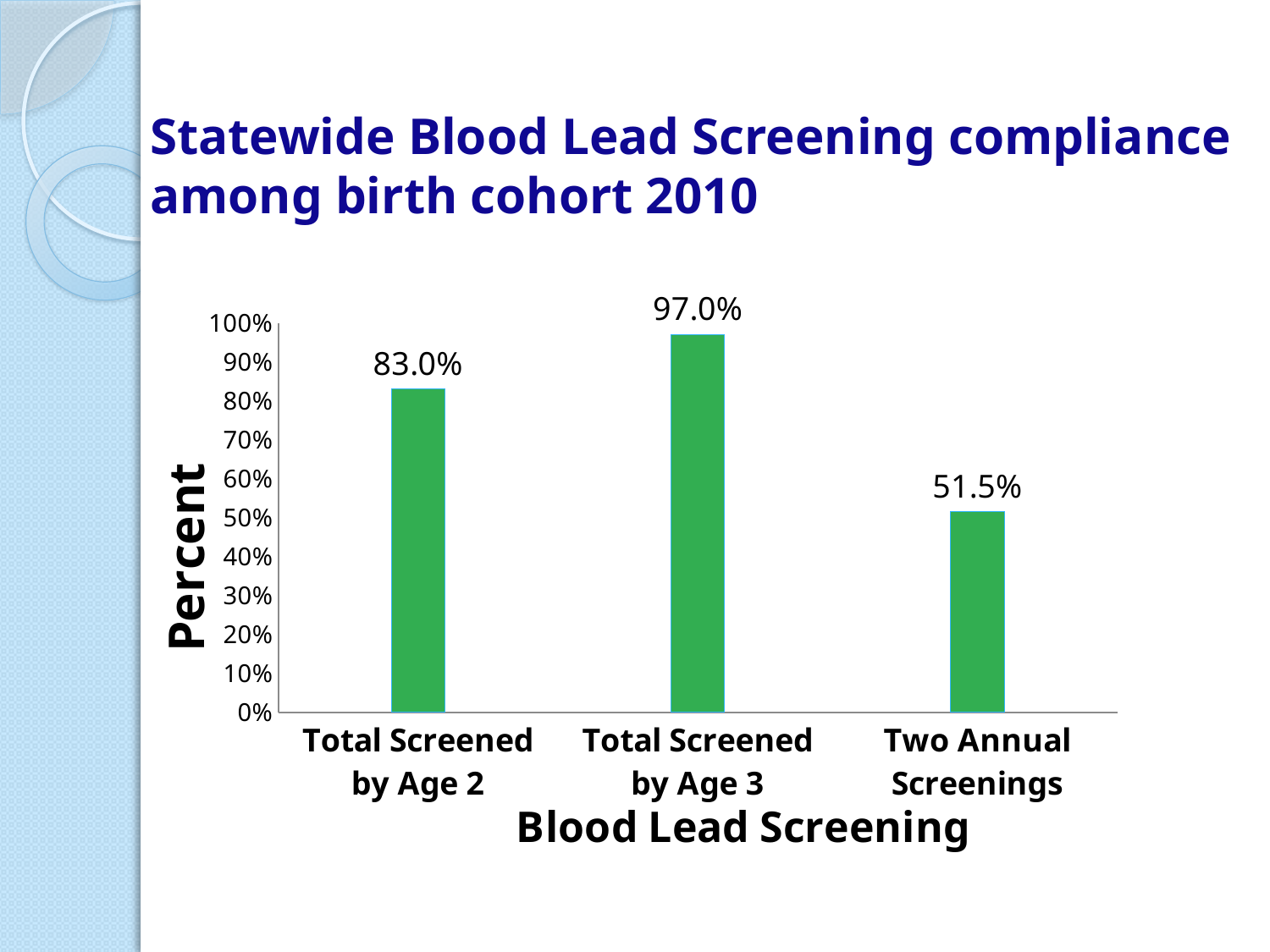
What is the difference between Total Screened by Age 2 and Two Annual Screenings? 31.5% How many categories are shown on the x axis? 3 What is the difference between Total Screened by Age 3 and Total Screened by Age 2? 14.0% Which category has the lowest value? Two Annual Screenings What is the value for Total Screened by Age 2? 83.0% What kind of chart is shown on the slide? bar chart Which is larger, Total Screened by Age 2 or Two Annual Screenings? Total Screened by Age 2 What is the value for Total Screened by Age 3? 97.0% What is the label of the y axis? Percent Which category has the highest value? Total Screened by Age 3 What is the value for Two Annual Screenings? 51.5% Is the value for Two Annual Screenings greater or less than 60%? less